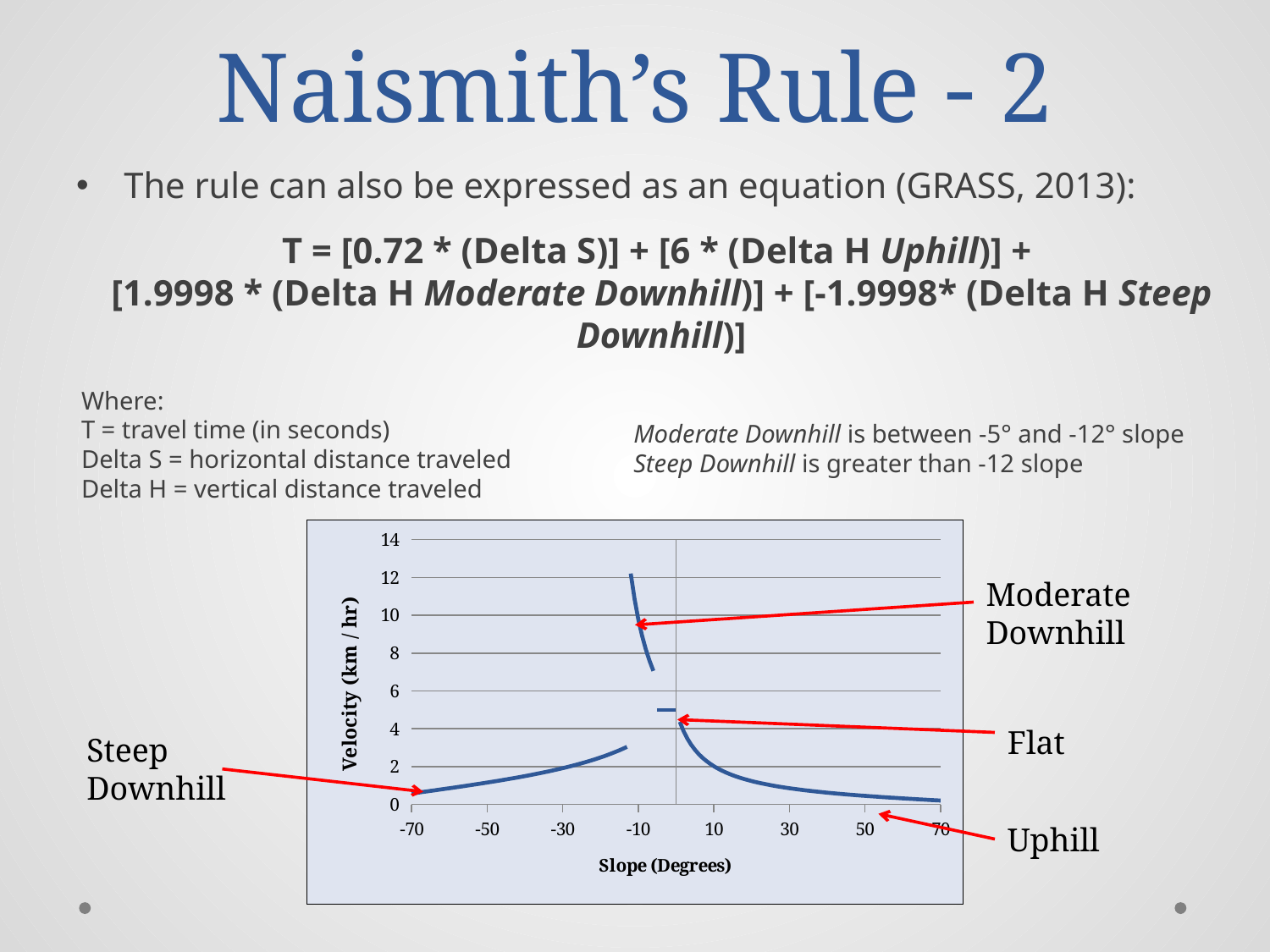
Is the velocity of the Steep Downhill segment at a slope of -70 degrees greater or less than 2 km/hr? less Which has the higher velocity: the Flat segment or the Uphill segment at a slope of 30 degrees? Flat What is the label of the horizontal axis of the chart? Slope (Degrees) What is the label of the vertical axis of the chart? Velocity (km / hr) What kind of chart is shown on the slide? line chart Does velocity rise or fall as slope increases along the Uphill segment? fall Is the velocity of the Flat segment greater or less than 4 km/hr? greater Does velocity rise or fall as slope increases from -70 toward -12 degrees along the Steep Downhill segment? rise Is the velocity of the Uphill segment at a slope of 50 degrees greater or less than 2 km/hr? less Which labeled segment of the chart reaches the highest velocity? Moderate Downhill How many labeled segments (Steep Downhill, Moderate Downhill, Flat, Uphill) does the chart show? 4